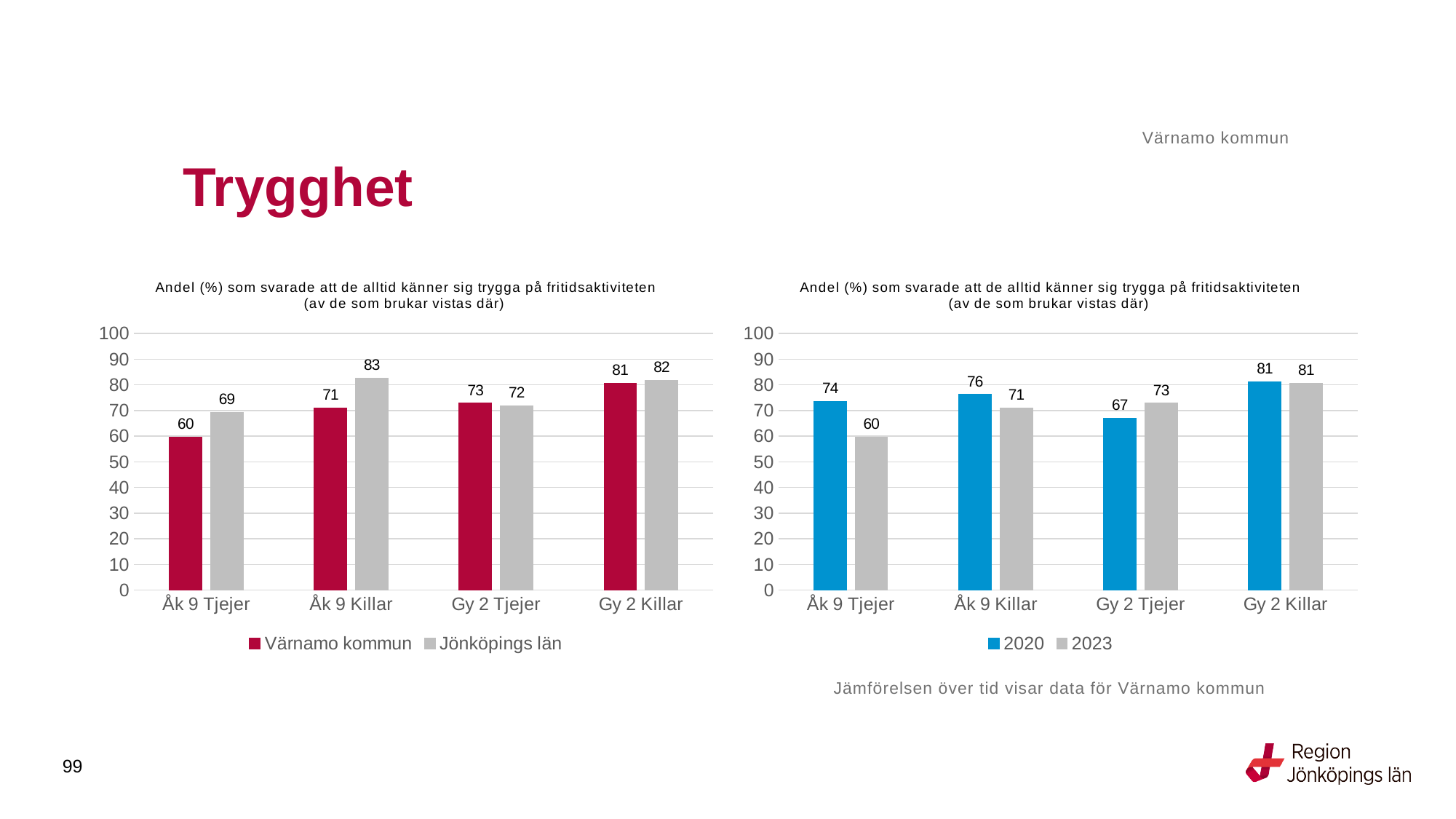
In the right chart, what is the difference between 2020 and 2023 for Åk 9 Tjejer? 14 In the left chart, what is the value for Värnamo kommun for Åk 9 Tjejer? 60 What kind of chart is the left chart? Bar chart In the right chart, what is the value for 2023 for Åk 9 Tjejer? 60 In the right chart, which category has the highest value for 2020? Gy 2 Killar In the left chart, what is the difference between Jönköpings län and Värnamo kommun for Åk 9 Killar? 12 In the left chart, which category has the highest value for Värnamo kommun? Gy 2 Killar In the left chart, which category has the lowest value for Jönköpings län? Åk 9 Tjejer In the left chart, which is larger for Gy 2 Tjejer: Värnamo kommun or Jönköpings län? Värnamo kommun In the right chart, what is the value for 2020 for Gy 2 Tjejer? 67 How many series does the legend of the right chart list? 2 In the left chart, what is the value for Jönköpings län for Åk 9 Killar? 83